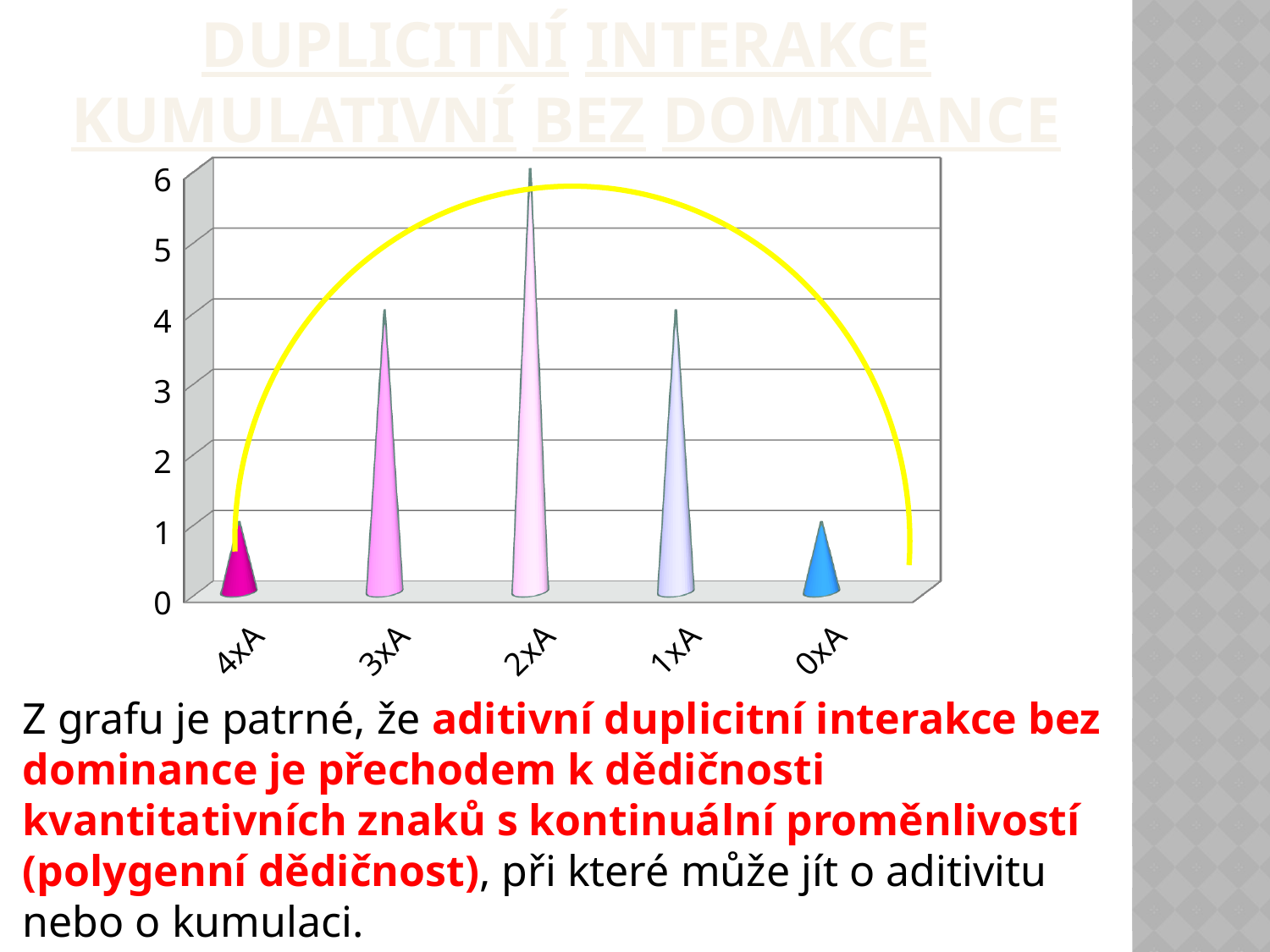
What is the difference between the values for 2xA and 4xA? 5 Which is larger, the value for 3xA or the value for 0xA? 3xA What is the value for 2xA? 6 Which category has the highest value? 2xA How many categories are shown on the x axis? 5 What is the difference between the values for 2xA and 3xA? 2 What kind of chart is this? bar chart What is the value for 0xA? 1 What is the value for 1xA? 4 Is the value for 2xA greater or less than 5? greater What is the value for 3xA? 4 Which two categories share the lowest value? 4xA and 0xA